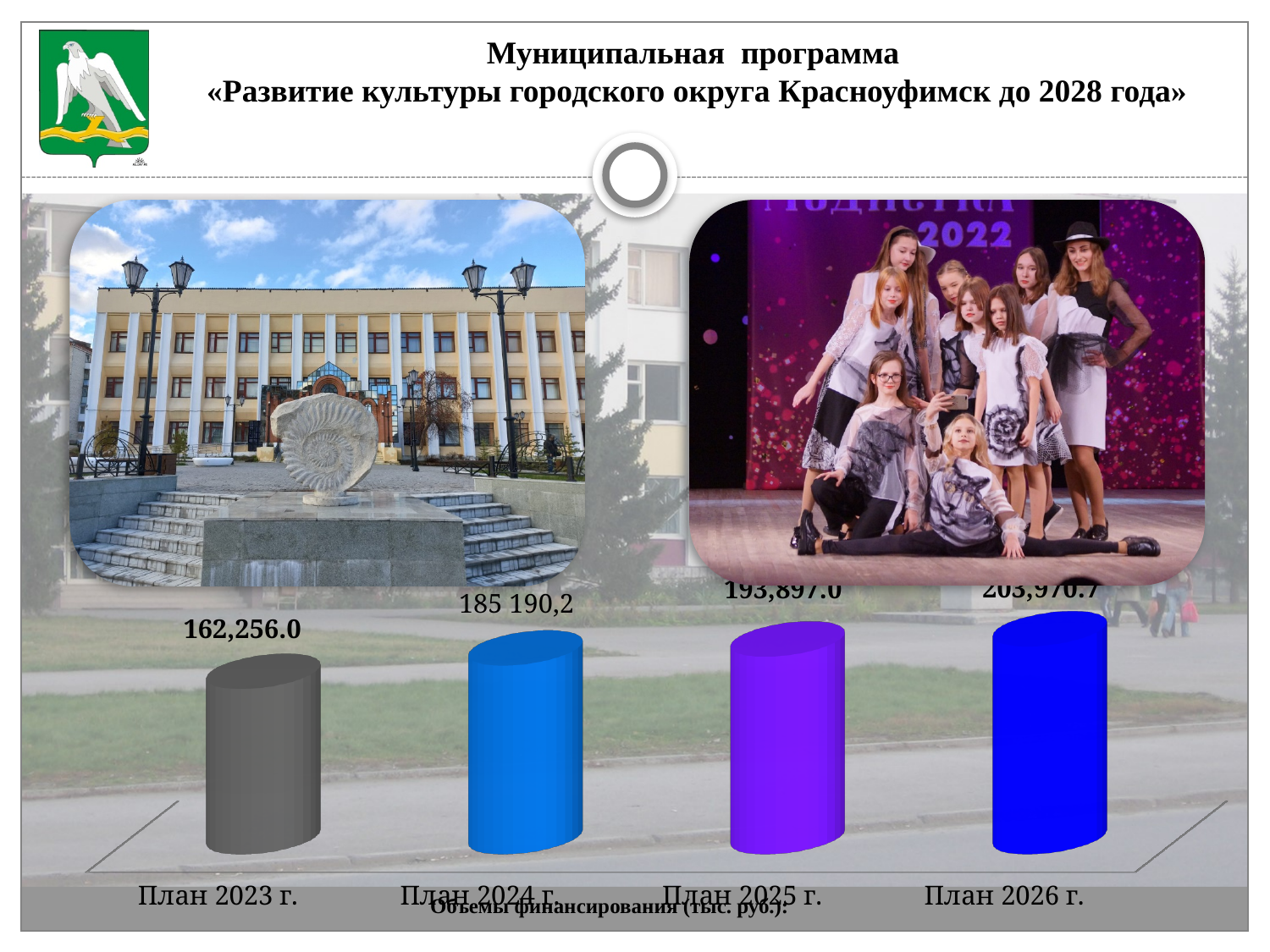
What colour is the bar for План 2023 г.? Gray Which is larger, the value for План 2024 г. or План 2023 г.? План 2024 г. Which year has the highest planned funding? План 2026 г. What is the planned funding value for План 2025 г.? 193,897.0 What is the planned funding value for План 2023 г.? 162,256.0 What is the planned funding value for План 2026 г.? 203,970.7 Do the planned funding values rise or fall from План 2023 г. to План 2026 г.? Rise What is the title of the chart? Объемы финансирования (тыс. руб.) What kind of chart is shown on the slide? Bar chart Which year has the lowest planned funding? План 2023 г. What is the planned funding value for План 2024 г.? 185 190,2 How many categories (years) are shown in the chart? 4